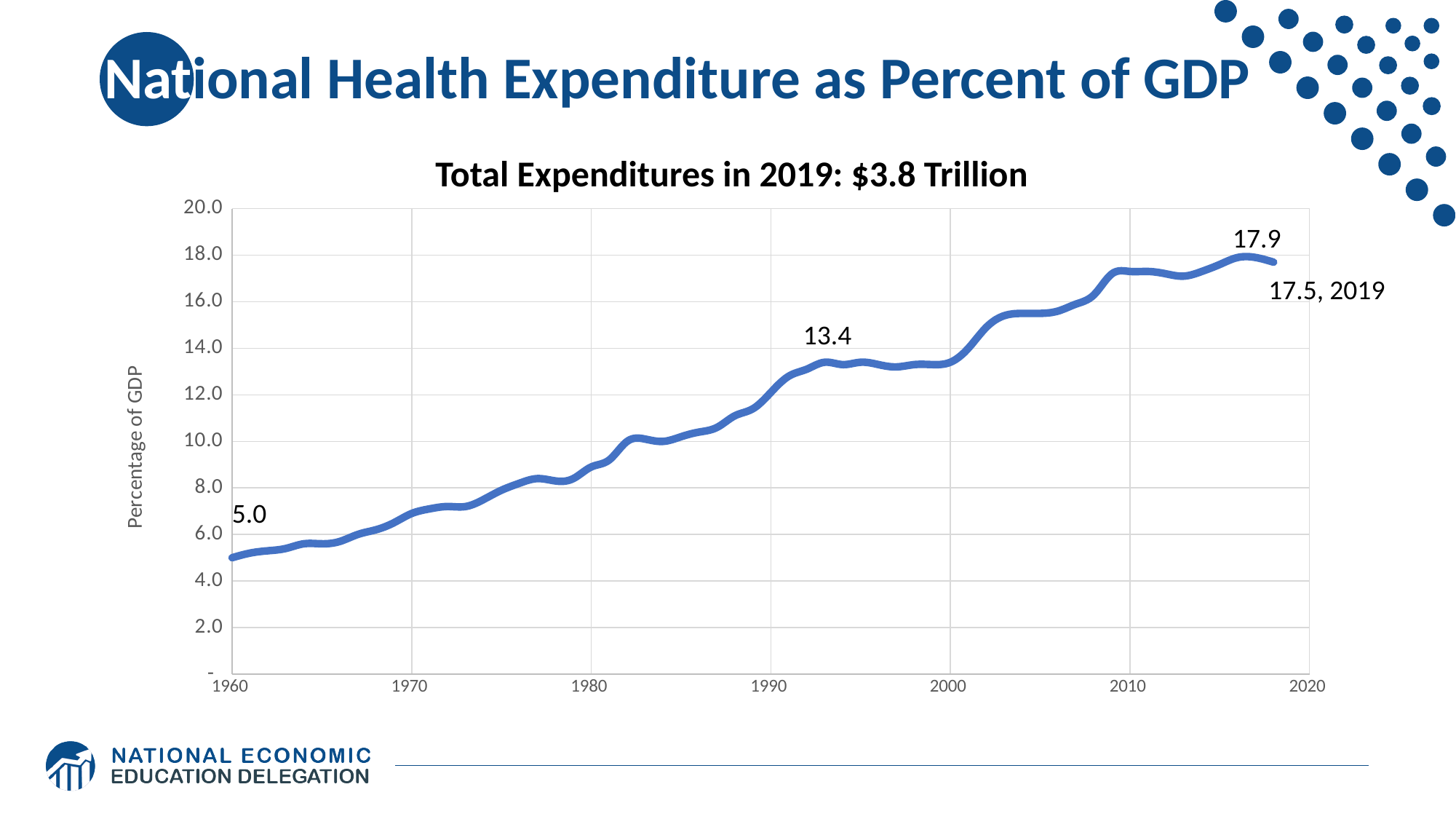
What kind of chart is shown on the slide? line chart What is the title shown above the chart? Total Expenditures in 2019: $3.8 Trillion Is the value for 1970 greater or less than 8.0? less What is the highest data label shown on the line? 17.9 What is the lowest data label shown on the line? 5.0 What is the difference between the 2019 value (17.5) and the 1960 value (5.0)? 12.5 What is the difference between the labeled values 17.9 and 13.4? 4.5 Is the value for 1980 greater or less than 8.0? greater Overall, do the values rise or fall from 1960 to 2019? rise What value is labeled for 2019 at the end of the line? 17.5 Which is larger, the value in 1960 or the value in 2019? 2019 What is the data label shown at the start of the line in 1960? 5.0